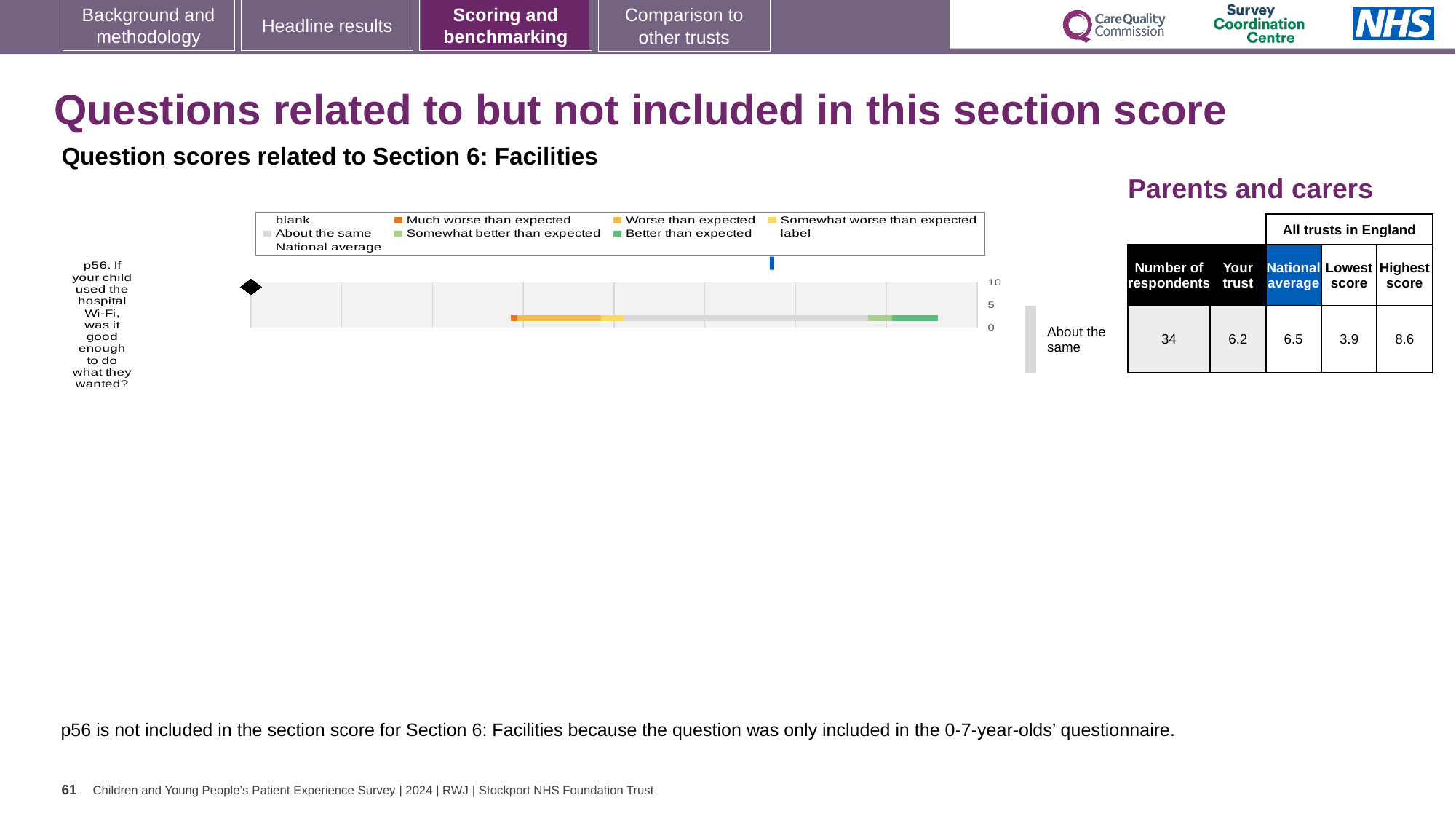
Which question number is plotted in the chart? p56 For p56, what is the difference between the Highest score and the Lowest score in the table? 4.7 In the table next to the chart, what is the Lowest score among all trusts in England for p56? 3.9 What kind of chart is shown for question p56? bar chart In the table next to the chart, what is the 'Your trust' score for p56? 6.2 How many entries does the chart legend list? 9 In the table next to the chart, what is the National average score for p56? 6.5 How many questions (categories) are plotted in the chart? 1 What is the highest tick value shown on the chart's score axis? 10 In the table next to the chart, how many respondents answered p56? 34 In the table next to the chart, what is the Highest score among all trusts in England for p56? 8.6 For p56, which is larger: the 'Your trust' score or the National average? National average